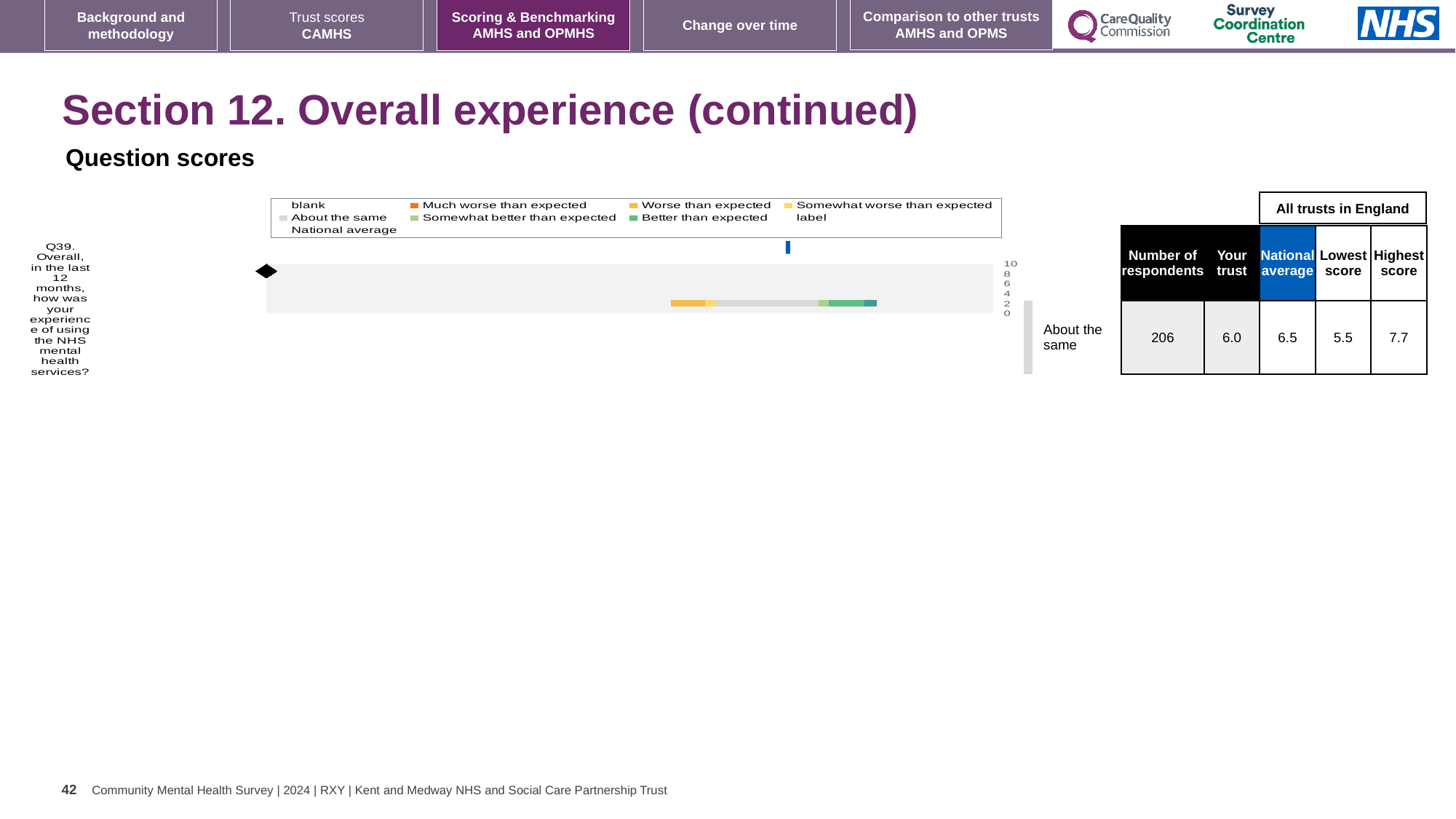
How many questions (categories) are plotted in the chart? 1 Which benchmark category is the trust's Q39 score placed in, according to the label beside the chart? About the same In the table beside the chart, what is the 'Your trust' score for Q39? 6.0 What kind of chart is shown on the slide for Q39? bar chart In the table beside the chart, what is the difference between the highest score and the lowest score for Q39? 2.2 In the table beside the chart, what is the national average for Q39? 6.5 Which legend entry is shown in grey? About the same In the table beside the chart, how many respondents answered Q39? 206 What is the highest value shown on the chart's axis? 10 Which legend entry is shown in orange? Much worse than expected How many entries does the chart legend list? 9 In the table beside the chart, which is larger for Q39: the trust's score or the national average? National average